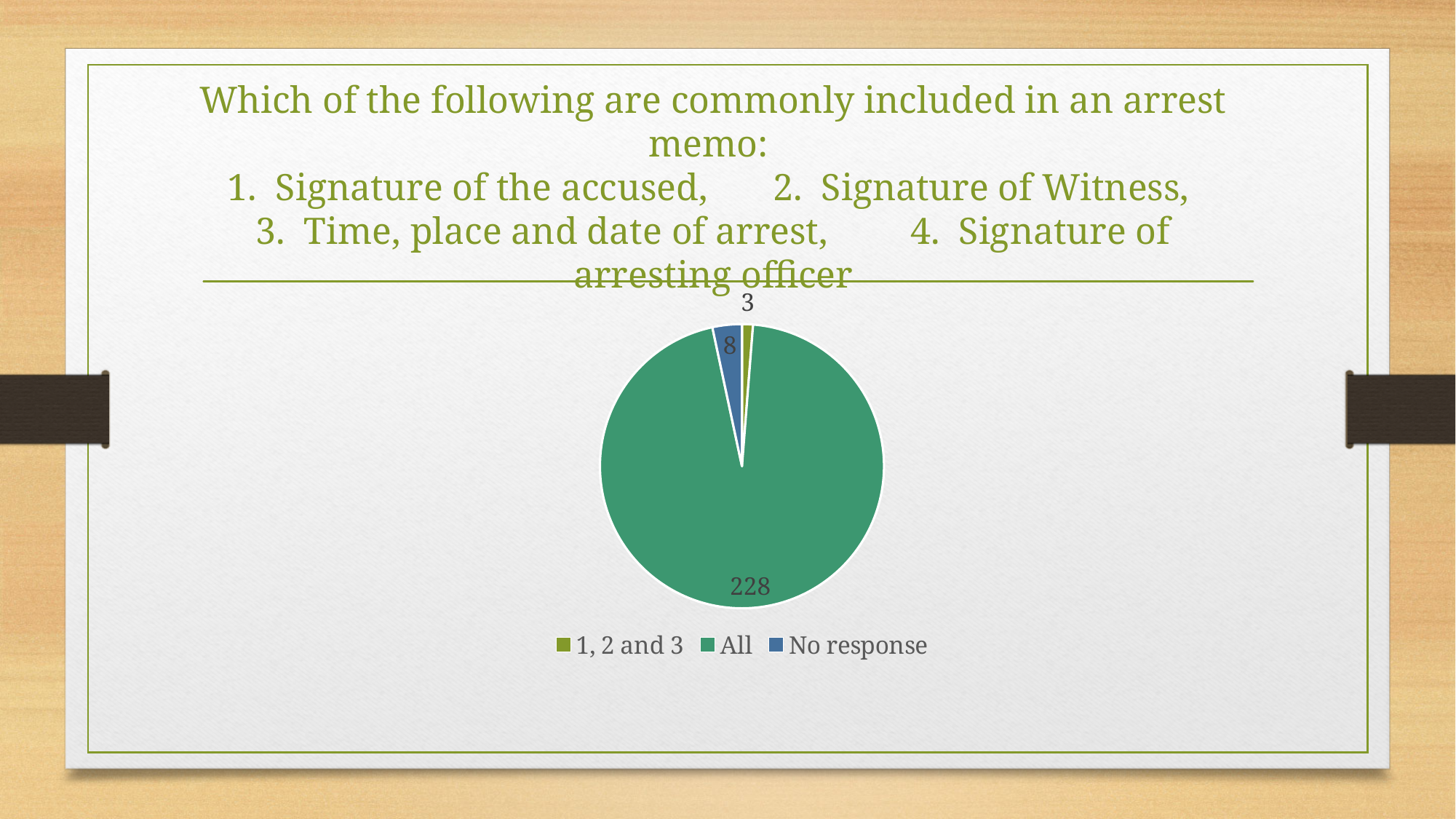
How many responses are in the "All" slice of the pie chart? 228 Which is larger, the "No response" slice or the "1, 2 and 3" slice? No response What type of chart is shown on the slide? Pie chart What is the difference between the "No response" value and the "1, 2 and 3" value? 5 Which category has the smallest slice of the pie chart? 1, 2 and 3 What colour is the "All" slice in the pie chart? Green How many categories does the pie chart legend list? 3 What is the difference between the "All" value and the "No response" value? 220 How many responses are in the "No response" slice of the pie chart? 8 Which category has the largest slice of the pie chart? All How many responses are in the "1, 2 and 3" slice of the pie chart? 3 What is the total number of responses across all slices of the pie chart? 239